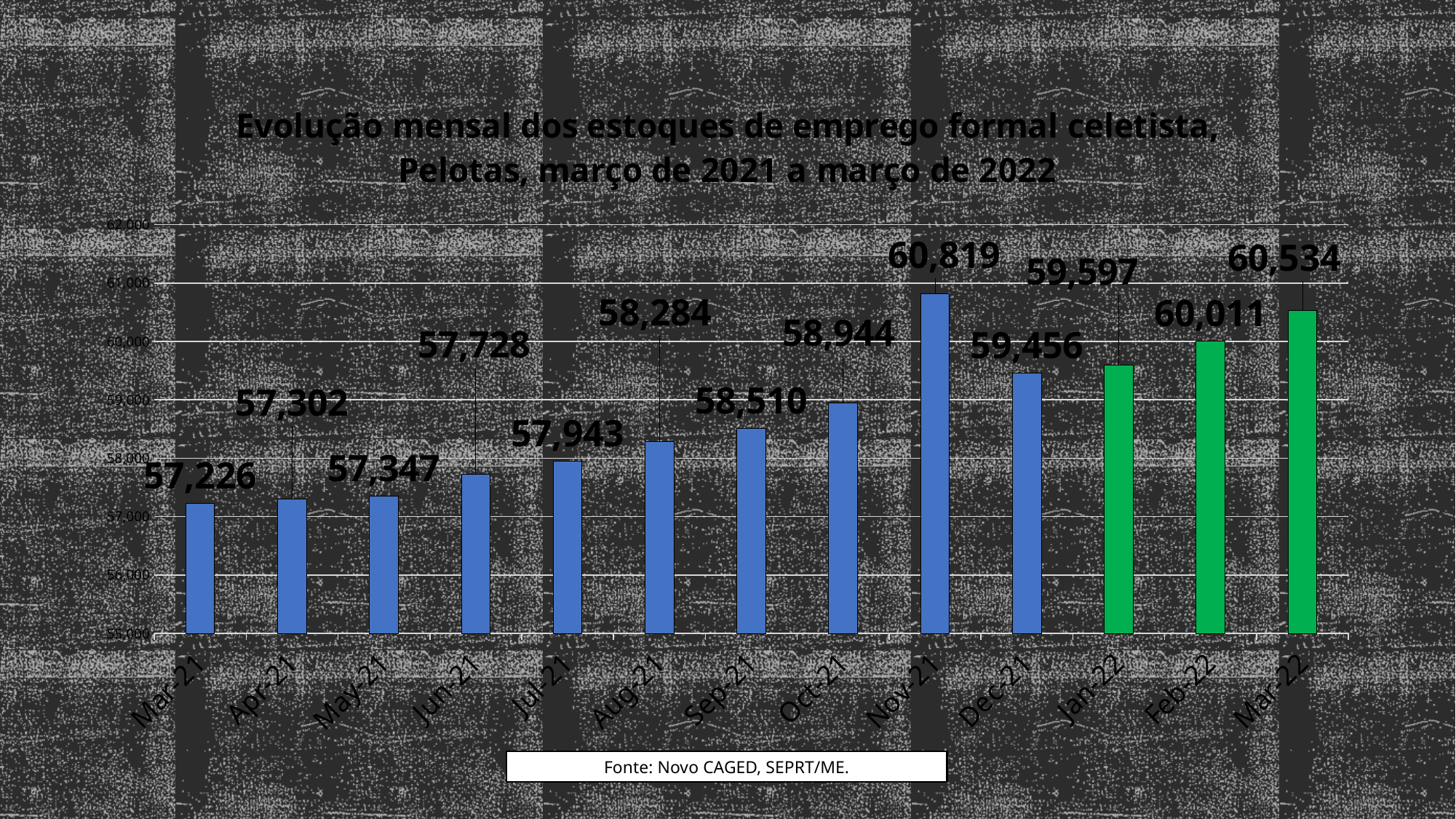
Which is larger, the value for Feb-22 or the value for Mar-22? Mar-22 What type of chart is shown on the slide? bar chart What colour are the bars for Jan-22, Feb-22 and Mar-22? green Which month has the highest value? Nov-21 Which month has the lowest value? Mar-21 How many months are plotted on the chart? 13 What is the value for Nov-21? 60,819 Is the value for Oct-21 greater or less than 59,000? less What is the difference between the values for Mar-22 and Mar-21? 3,308 What is the value for Jan-22? 59,597 What is the difference between the values for Nov-21 and Dec-21? 1,363 What is the value for Mar-21? 57,226